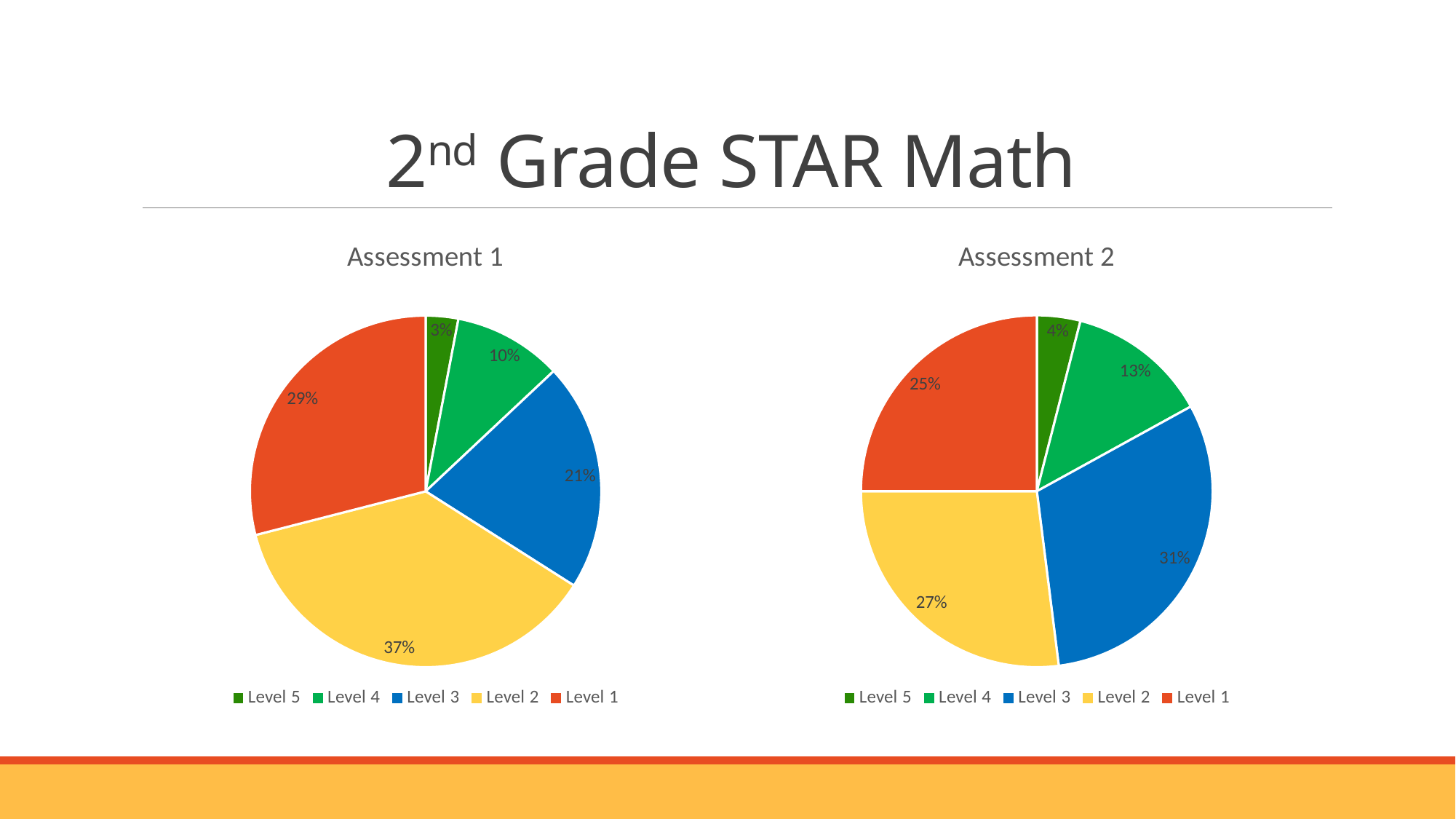
In the Assessment 2 chart, what percentage is shown for Level 3? 31% What type of chart is used for Assessment 2? Pie chart In the Assessment 1 chart, what is the difference in percentage points between Level 1 and Level 3? 8 In the Assessment 2 chart, what percentage is shown for Level 1? 25% How many slices does the Assessment 1 pie chart have? 5 In the Assessment 1 chart, what percentage is shown for Level 5? 3% In the Assessment 1 chart, what percentage is shown for Level 2? 37% In the Assessment 2 chart, which level has the smallest slice? Level 5 In the Assessment 2 chart, which is larger, the Level 2 slice or the Level 4 slice? Level 2 In the Assessment 1 chart, what colour is the Level 3 slice? Blue In the Assessment 2 chart, which level has the largest slice? Level 3 In the Assessment 1 chart, which level has the largest slice? Level 2